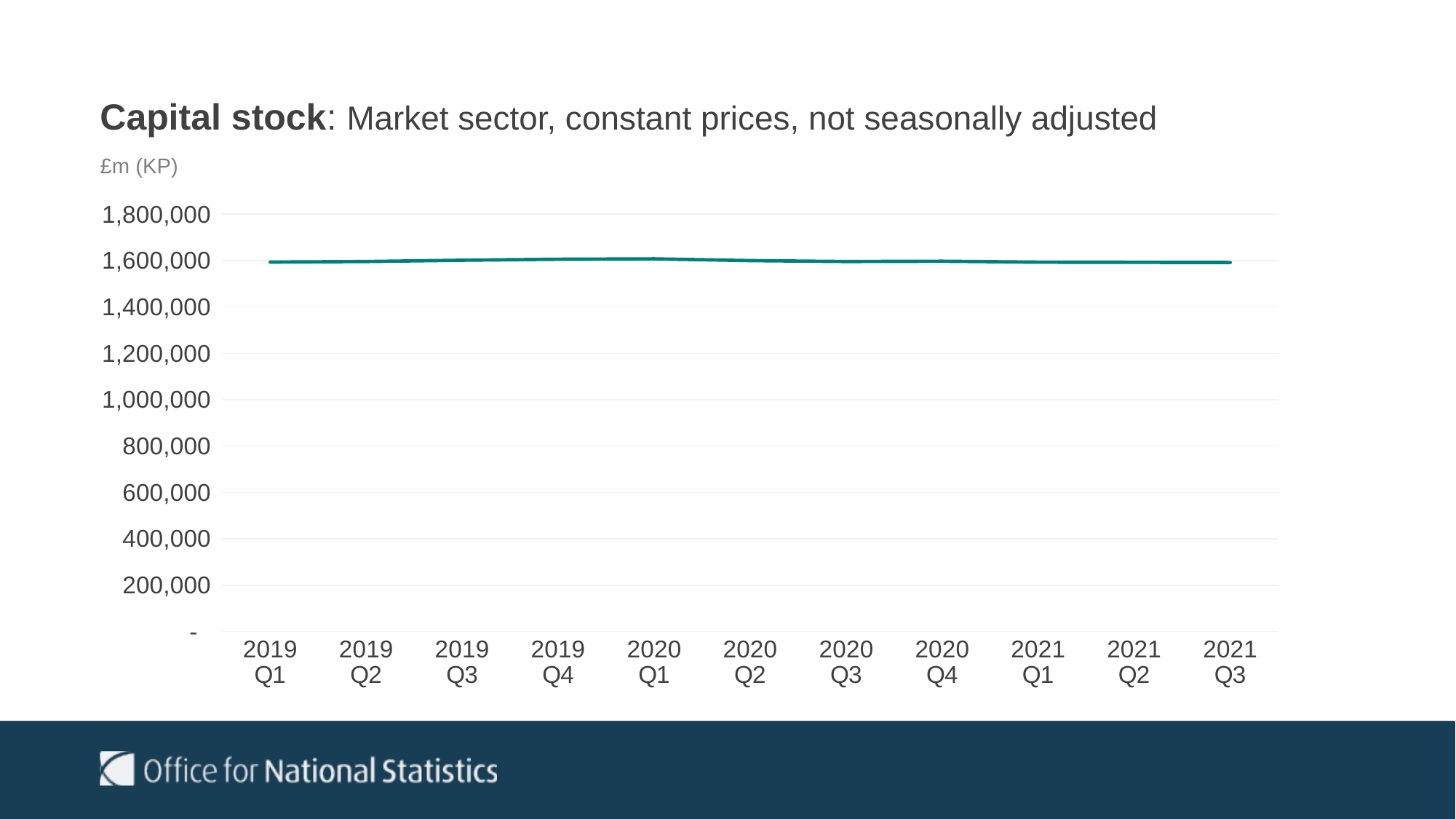
What kind of chart is shown on the slide? line chart What is the highest tick value shown on the y axis? 1,800,000 Is the value for 2020 Q4 greater or less than 1,800,000? less What is the last quarter shown on the x axis? 2021 Q3 What is the first quarter shown on the x axis? 2019 Q1 Is the value for 2021 Q3 greater or less than 1,800,000? less Is the value for 2020 Q1 greater or less than 1,000,000? greater How many quarterly points are plotted on the chart? 11